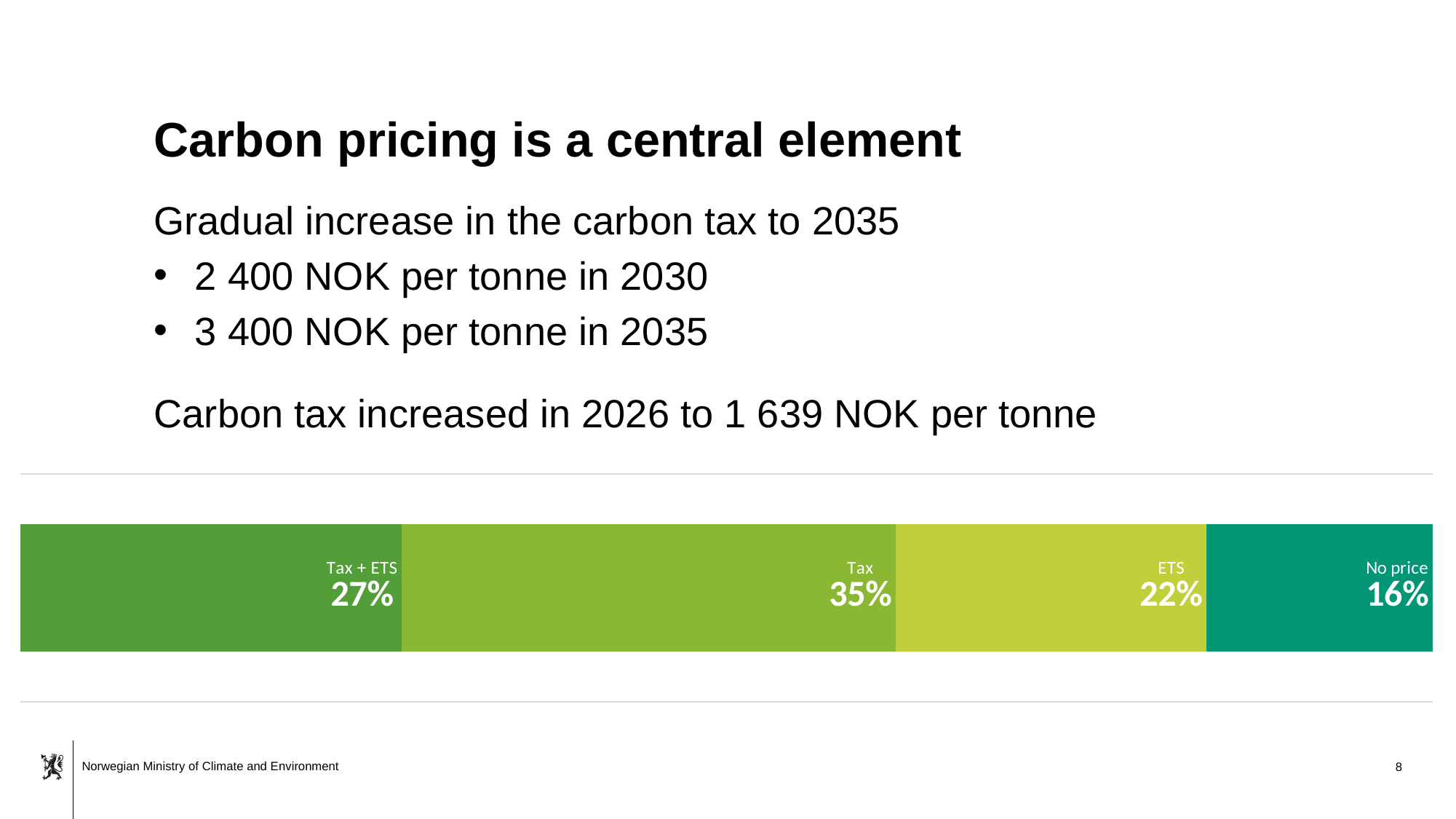
What is the difference between the "Tax" share and the "ETS" share? 13% What share of the stacked bar is labelled "ETS"? 22% How many segments does the stacked bar have? 4 What kind of chart is shown on the slide? Stacked bar chart What is the difference between the "Tax + ETS" share and the "No price" share? 11% What share of the stacked bar is labelled "Tax"? 35% What share of the stacked bar is labelled "Tax + ETS"? 27% Which segment of the stacked bar has the smallest share? No price What is the total of all segments in the stacked bar? 100% What share of the stacked bar is labelled "No price"? 16% Which segment of the stacked bar has the largest share? Tax Which is larger, the "Tax + ETS" share or the "ETS" share? Tax + ETS